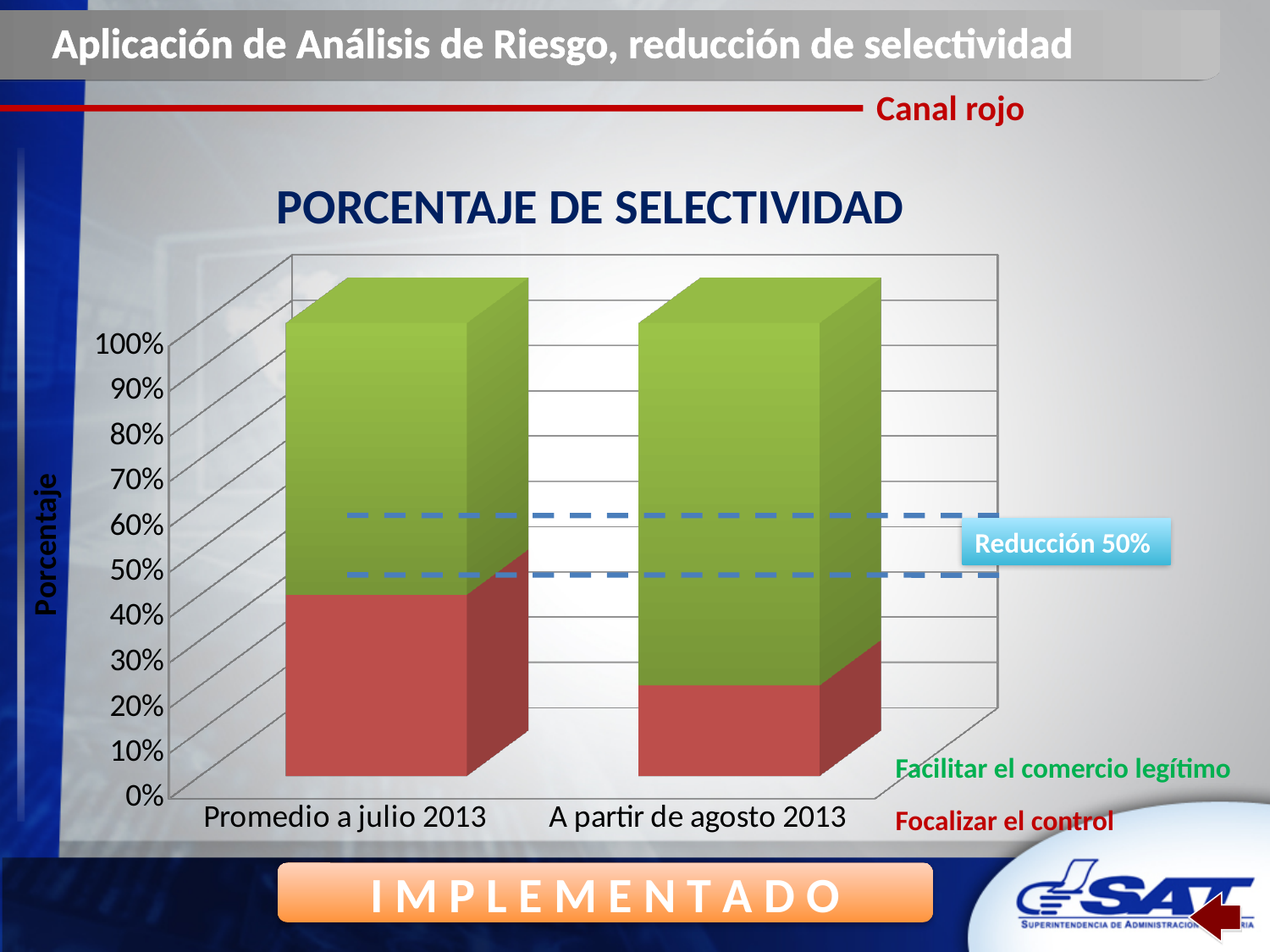
What is the title of the chart? PORCENTAJE DE SELECTIVIDAD Is the red segment for 'A partir de agosto 2013' greater or less than 30%? less What is the label of the vertical axis? Porcentaje What kind of chart is shown on the slide? stacked bar chart Is the red segment for 'Promedio a julio 2013' greater or less than 30%? greater What reduction does the annotation next to the chart state? Reducción 50% What is the label of the first category on the x axis? Promedio a julio 2013 What is the highest value shown on the vertical axis? 100% Which category has the larger red segment, 'Promedio a julio 2013' or 'A partir de agosto 2013'? Promedio a julio 2013 What is the label of the second category on the x axis? A partir de agosto 2013 How many categories are shown on the x axis of the chart? 2 Does the red segment rise or fall from 'Promedio a julio 2013' to 'A partir de agosto 2013'? fall